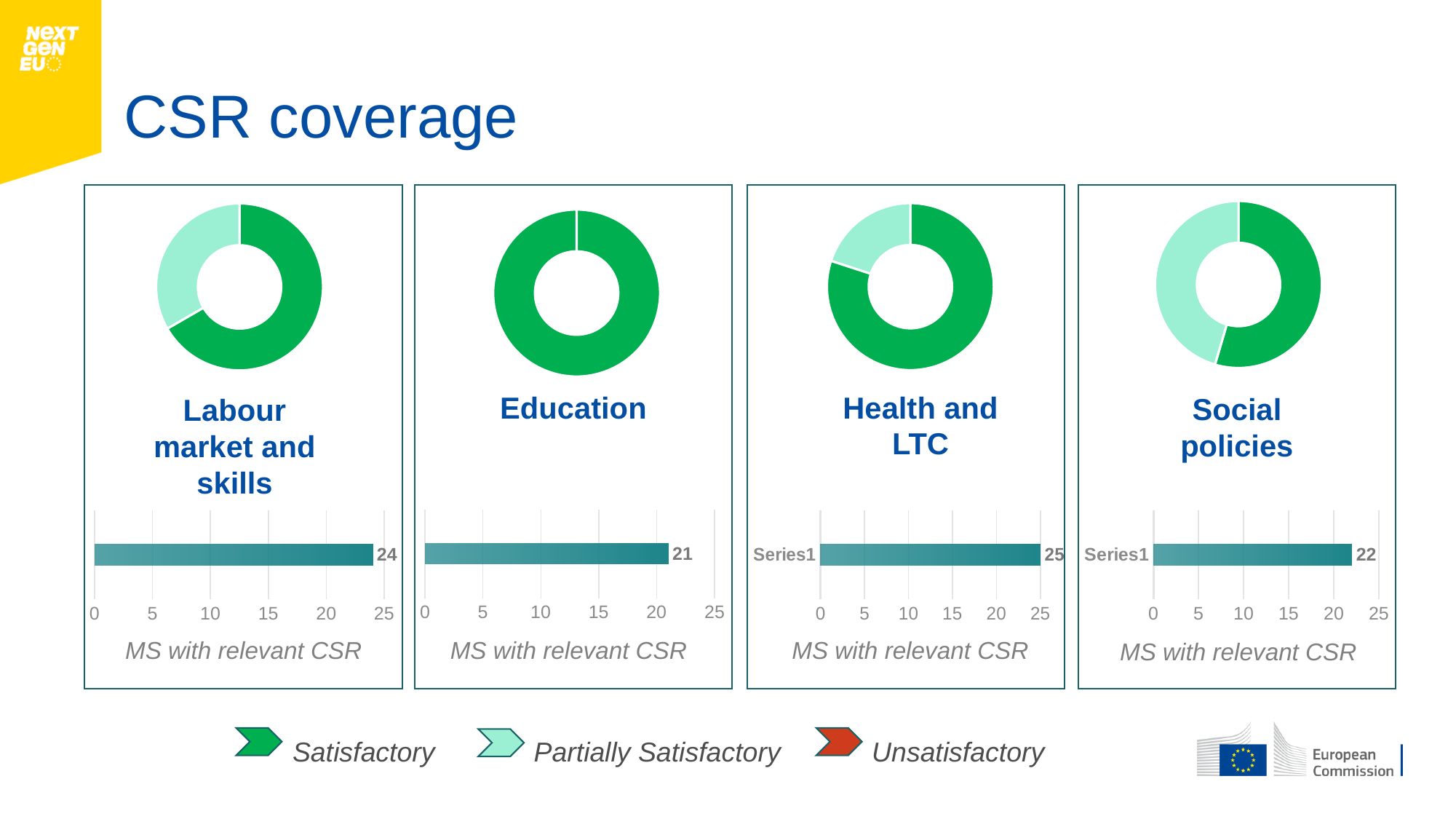
What kind of chart is shown at the bottom of each panel? Bar chart Across the four bar charts, which policy area has the lowest number of MS with relevant CSR? Education How many categories does the legend at the bottom of the slide list? 3 In the Health and LTC panel, what value does the bar chart show for MS with relevant CSR? 25 Across the four bar charts, which policy area has the highest number of MS with relevant CSR? Health and LTC Which has more MS with relevant CSR: Labour market and skills or Social policies? Labour market and skills In the Education panel, what value does the bar chart show for MS with relevant CSR? 21 What kind of chart is shown at the top of each panel? Donut chart In the Social policies panel, what value does the bar chart show for MS with relevant CSR? 22 In the Education donut chart, which category takes up the larger share: Satisfactory or Partially Satisfactory? Satisfactory What is the difference between the MS with relevant CSR values for Health and LTC and for Education? 4 In the Labour market and skills panel, what value does the bar chart show for MS with relevant CSR? 24